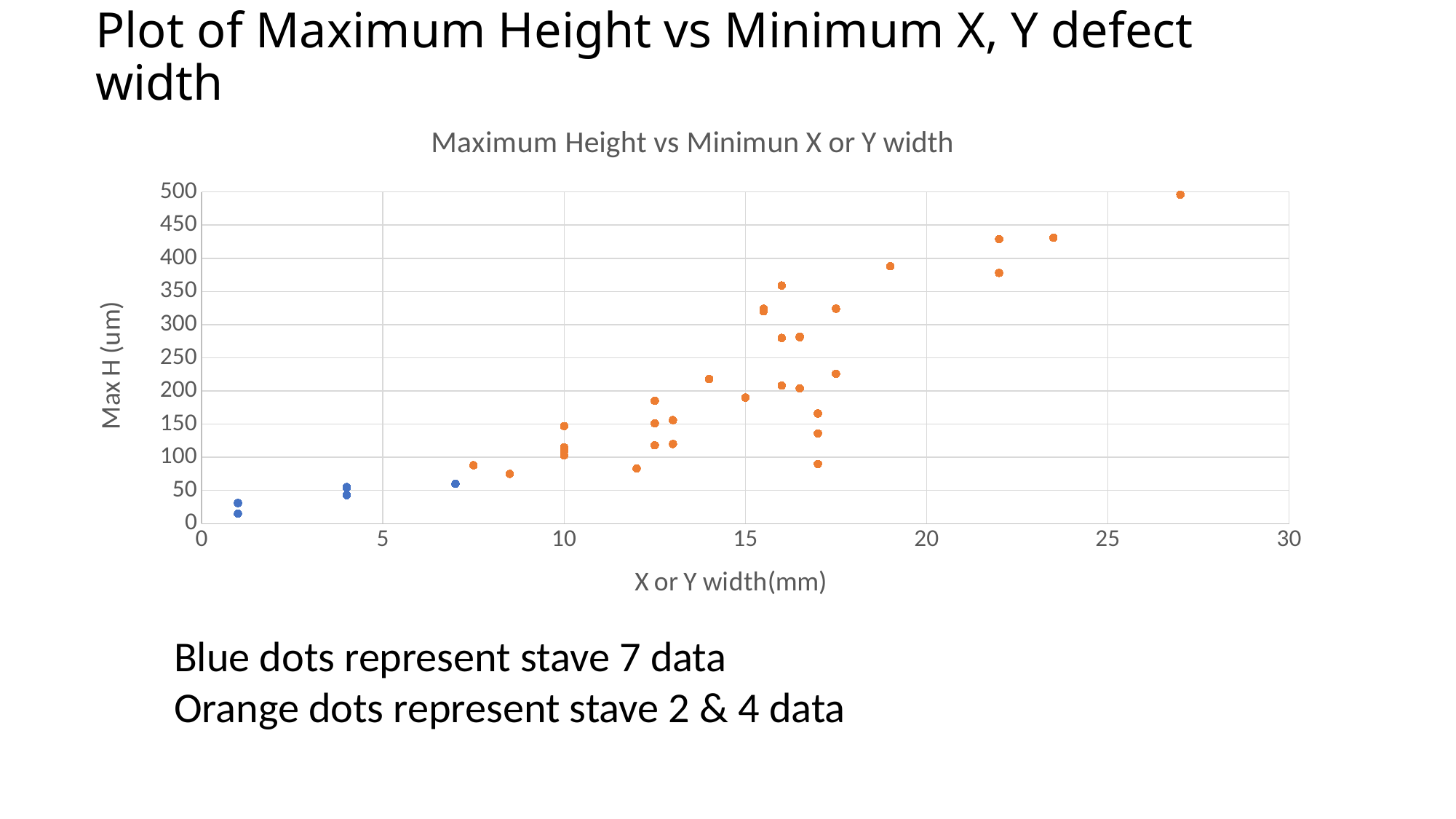
What is the label of the y axis? Max H (um) Is the Max H value of the point at about 19 mm width greater or less than 350? greater What kind of chart is shown on the slide? scatter plot What is the highest value shown on the y axis? 500 Which colour of dots reaches the highest Max H values, blue or orange? orange Are the Max H values of the blue points at about 1 mm width greater or less than 50? less Do the Max H values generally rise or fall as X or Y width increases? rise What is the title of the chart? Maximum Height vs Minimun X or Y width Is the Max H value of the point at about 23.5 mm width greater or less than 400? greater Which point has the highest Max H value, the one at about 27 mm width or the one at about 22 mm width? the one at about 27 mm width